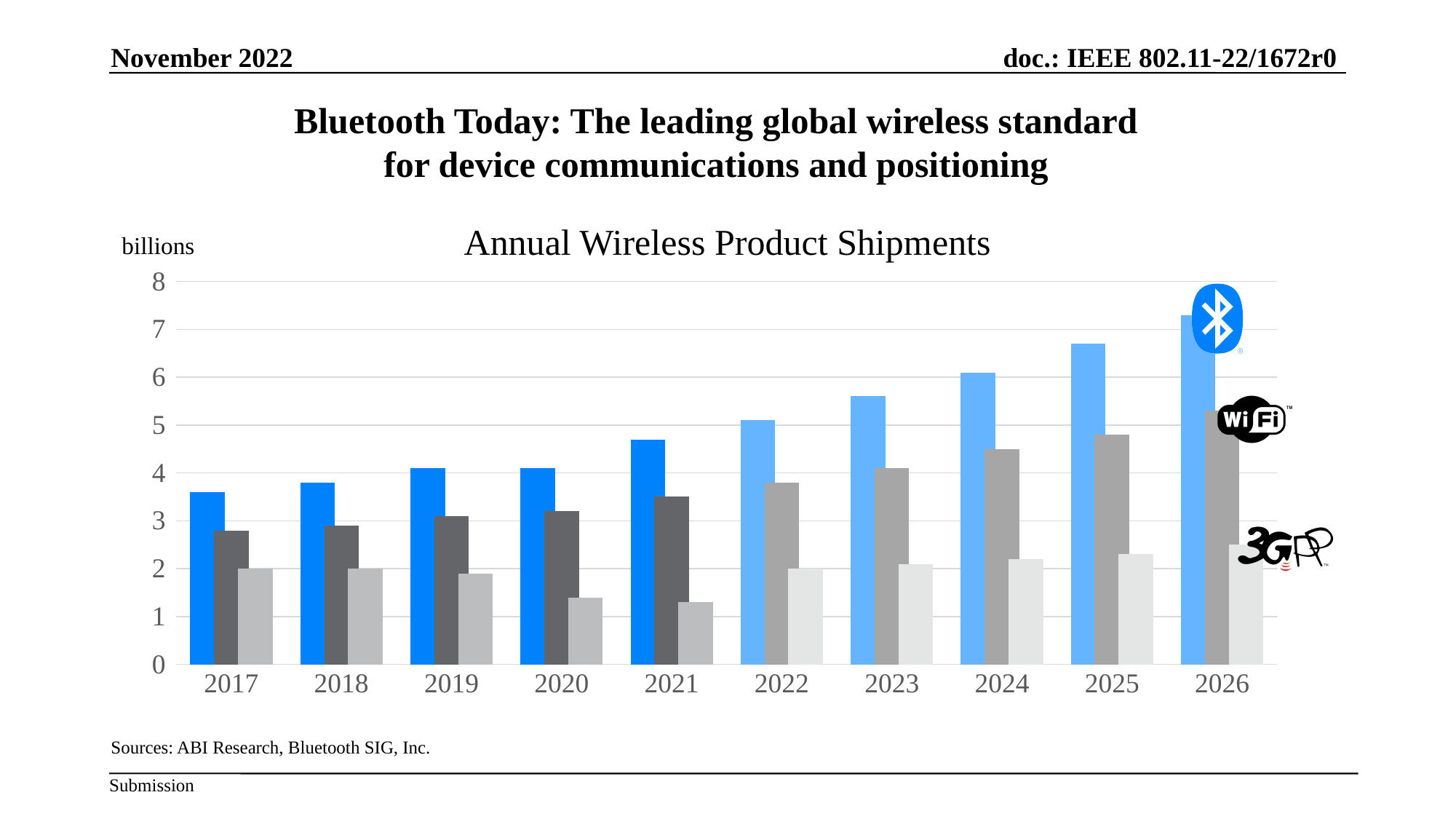
How many series (bars per year) does the chart show? 3 In which year is the Bluetooth (blue) bar the lowest? 2017 Do the Bluetooth (blue) bars rise or fall from 2017 to 2026? rise Is the Wi-Fi (dark gray) value for 2021 greater or less than 4? less Is the Bluetooth (blue) value for 2026 greater or less than 7? greater Is the 3GPP (light gray) value for 2020 greater or less than 2? less How many years are shown on the x axis of the chart? 10 What is the title of the chart? Annual Wireless Product Shipments Which is larger in 2024, the Bluetooth (blue) bar or the Wi-Fi (gray) bar? Bluetooth What type of chart is shown on the slide? bar chart In which year is the Bluetooth (blue) bar the highest? 2026 What unit is indicated for the y axis of the chart? billions